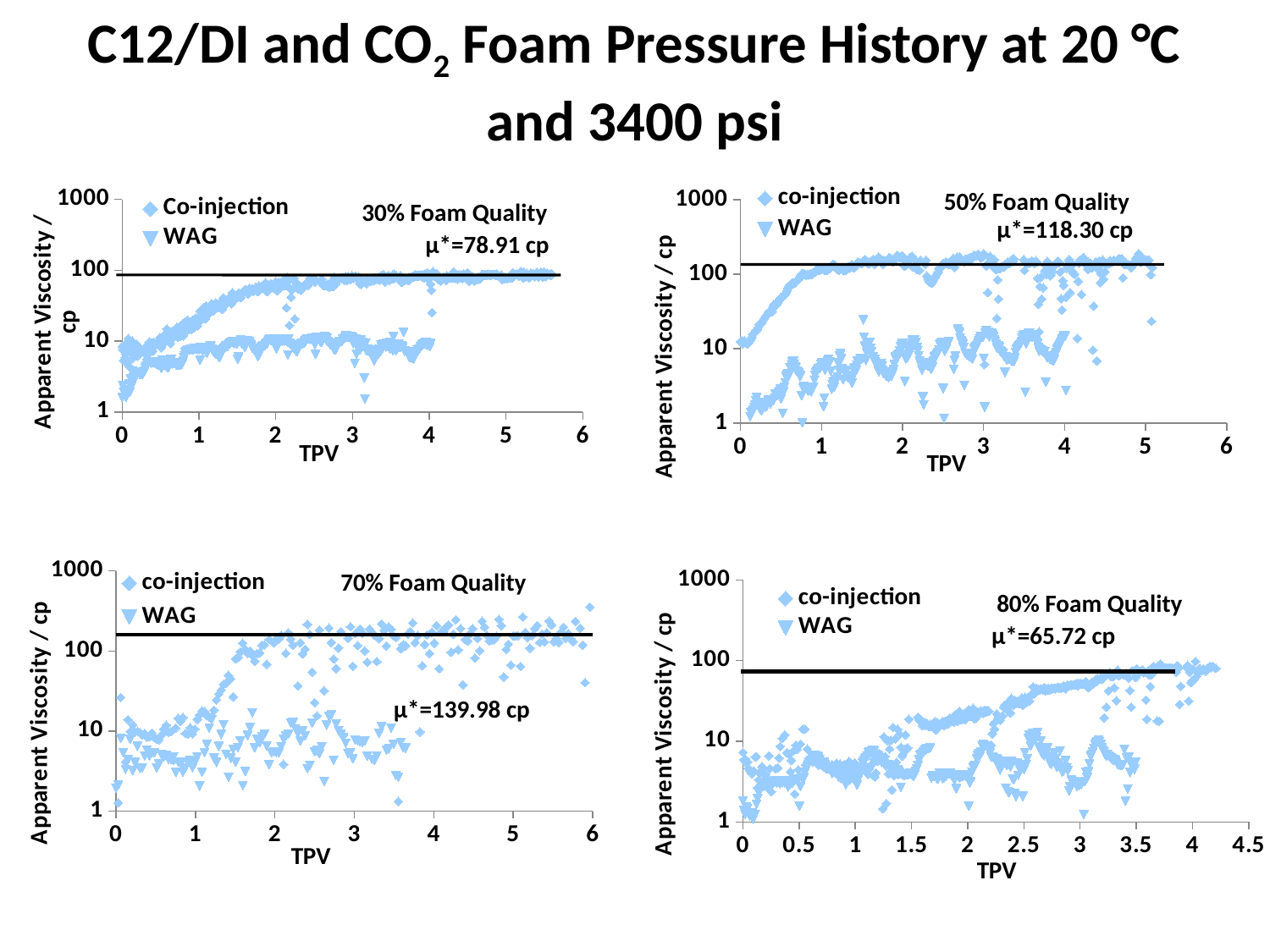
In the 80% Foam Quality chart (bottom right), is the WAG value at TPV 1 greater or less than 10? less What is the difference between the μ* value in the 70% Foam Quality chart and the μ* value in the 80% Foam Quality chart? 74.26 cp In the 30% Foam Quality chart (top left), what is the value of μ* shown? 78.91 cp In the 70% Foam Quality chart (bottom left), what is the value of μ* shown? 139.98 cp In the 80% Foam Quality chart (bottom right), what is the value of μ* shown? 65.72 cp How many charts are shown on the slide? 4 Across the four charts, which foam quality has the highest μ* value? 70% Foam Quality What kind of chart is the 80% Foam Quality chart (bottom right)? Scatter chart In the 50% Foam Quality chart (top right), what is the value of μ* shown? 118.30 cp How many series does the legend of the 30% Foam Quality chart list? 2 Across the four charts, which foam quality has the lowest μ* value? 80% Foam Quality Which has the larger μ* value: the 50% Foam Quality chart or the 30% Foam Quality chart? 50% Foam Quality